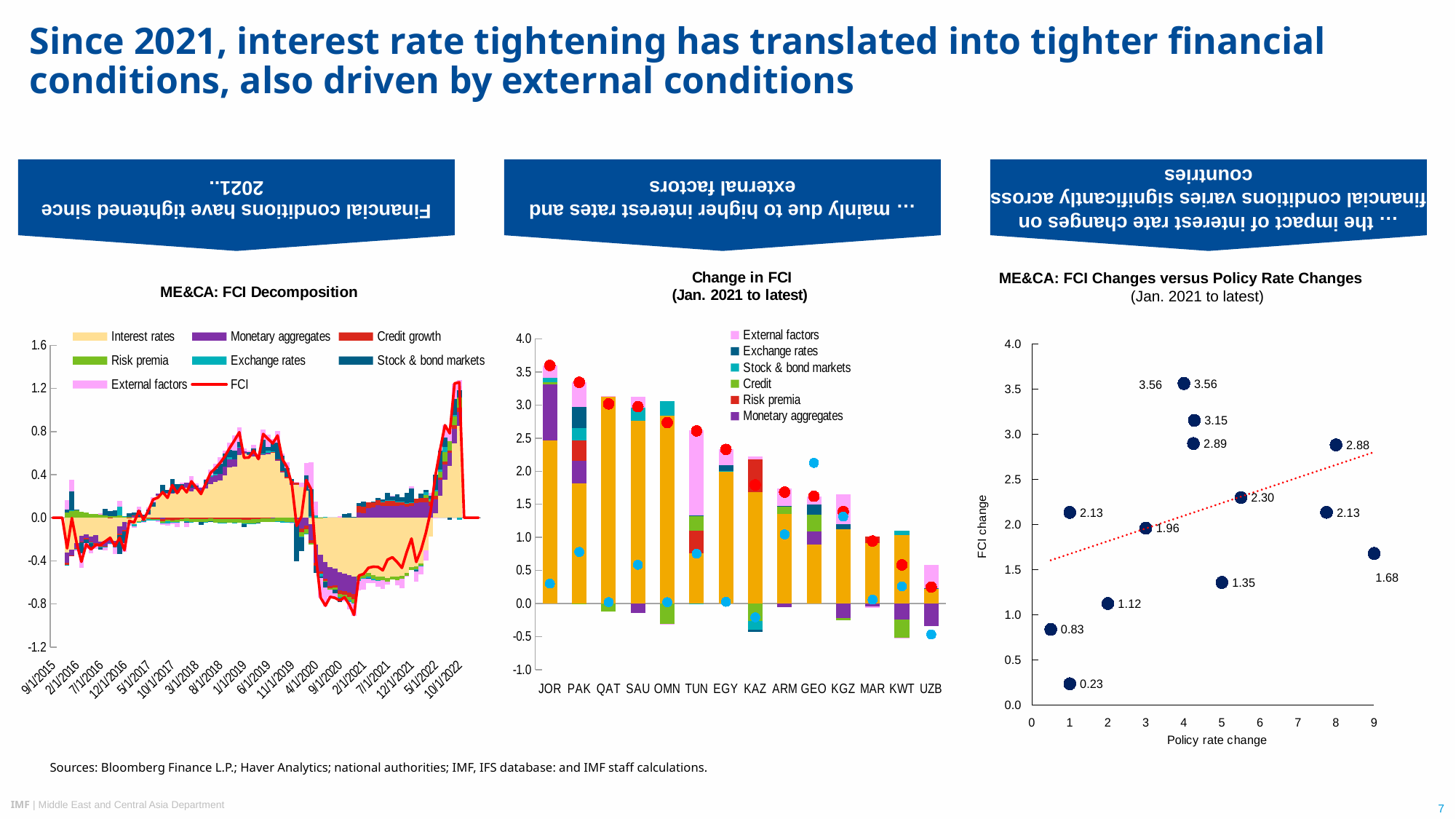
How many countries are shown on the x axis of the 'Change in FCI (Jan. 2021 to latest)' chart? 14 In 'ME&CA: FCI Changes versus Policy Rate Changes', what is the difference between the highest labelled value (3.56) and the lowest labelled value (0.23)? 3.33 What kind of chart is 'ME&CA: FCI Changes versus Policy Rate Changes'? scatter chart In 'Change in FCI (Jan. 2021 to latest)', which country has the tallest bar? JOR In 'ME&CA: FCI Changes versus Policy Rate Changes', does the dotted trend line rise or fall as policy rate change increases? rises In 'ME&CA: FCI Changes versus Policy Rate Changes', what is the lowest labelled FCI change value? 0.23 What kind of chart is 'Change in FCI (Jan. 2021 to latest)'? bar chart In 'Change in FCI (Jan. 2021 to latest)', is the red dot for UZB greater or less than 0.5? less In 'ME&CA: FCI Changes versus Policy Rate Changes', what is the label of the horizontal axis? Policy rate change How many entries does the legend of the 'ME&CA: FCI Decomposition' chart list? 8 In 'ME&CA: FCI Changes versus Policy Rate Changes', what is the highest labelled FCI change value? 3.56 How many entries does the legend of the 'Change in FCI (Jan. 2021 to latest)' chart list? 6